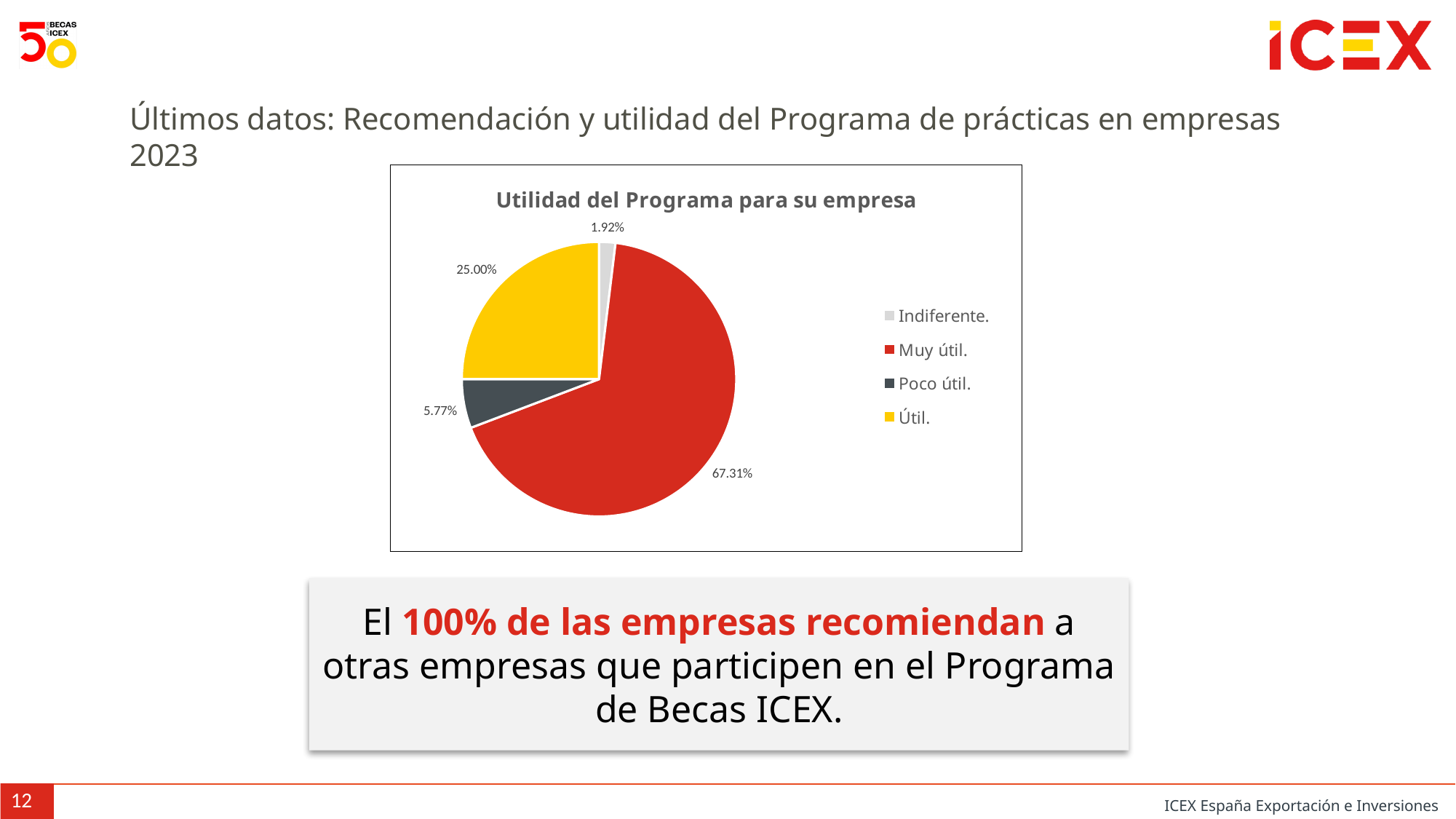
What colour represents "Útil." in the pie chart? Yellow What percentage of the pie corresponds to "Útil."? 25.00% Which category has the largest share of the pie? Muy útil. How many categories does the legend list? 4 Which category has the smallest share of the pie? Indiferente. What is the title of the chart? Utilidad del Programa para su empresa What is the difference in percentage points between "Muy útil." and "Útil."? 42.31 What kind of chart is shown on the slide? Pie chart What percentage of the pie corresponds to "Indiferente."? 1.92% What percentage of the pie corresponds to "Poco útil."? 5.77% Which is larger, the share for "Útil." or the share for "Poco útil."? Útil. What percentage of the pie corresponds to "Muy útil."? 67.31%